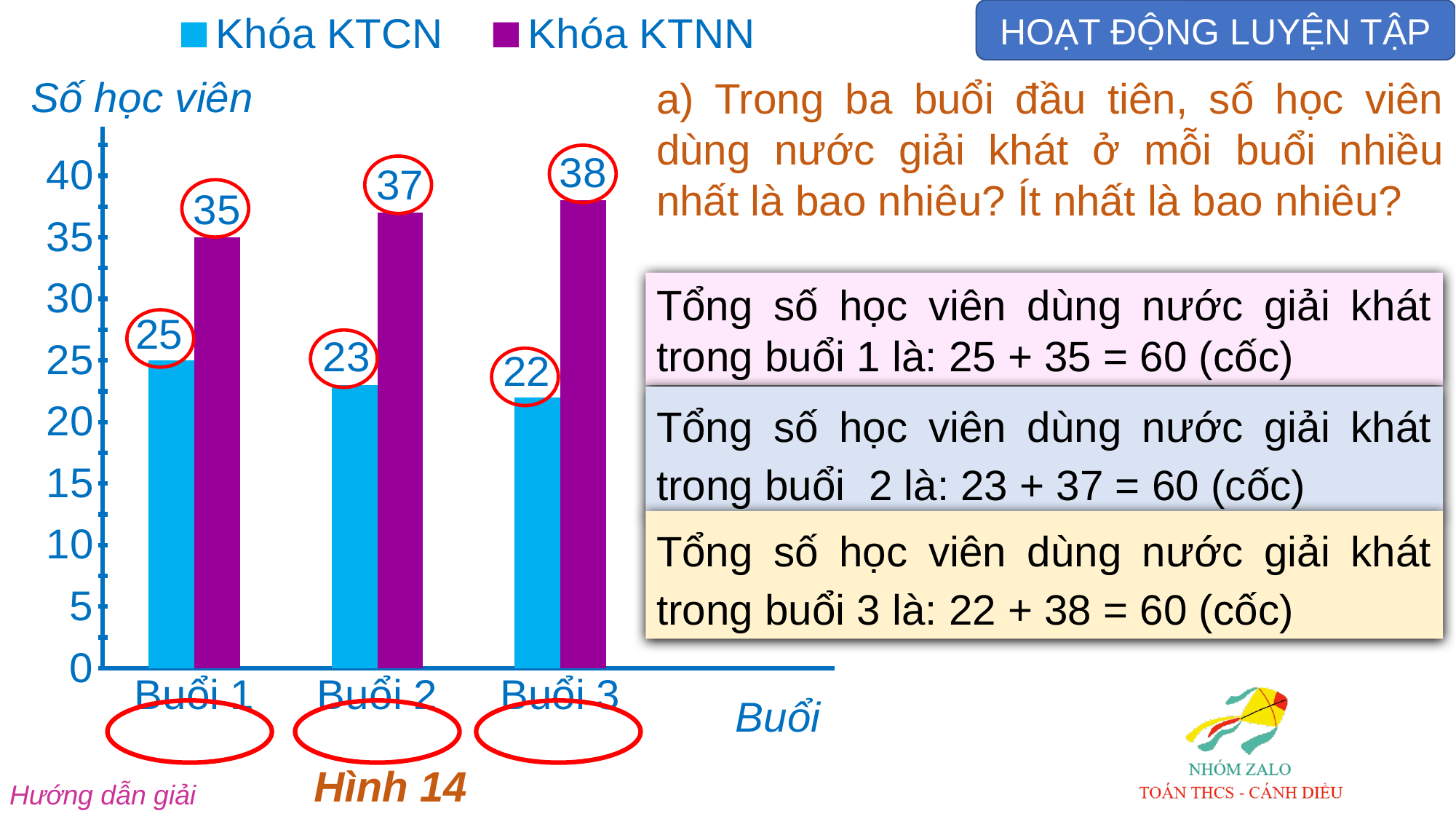
Which session (Buổi) has the lowest value for Khóa KTCN? Buổi 3 Which session (Buổi) has the highest value for Khóa KTNN? Buổi 3 What is the value for Khóa KTNN in Buổi 2? 37 How many series does the legend list? 2 How many sessions (Buổi) are shown on the x axis? 3 Is the value for Khóa KTCN in Buổi 3 greater or less than 25? less Which is larger in Buổi 2: Khóa KTCN or Khóa KTNN? Khóa KTNN Do the values for Khóa KTCN rise or fall from Buổi 1 to Buổi 3? fall What kind of chart is shown? bar chart What is the difference between Khóa KTNN and Khóa KTCN in Buổi 1? 10 What is the value for Khóa KTCN in Buổi 1? 25 What is the value for Khóa KTNN in Buổi 3? 38